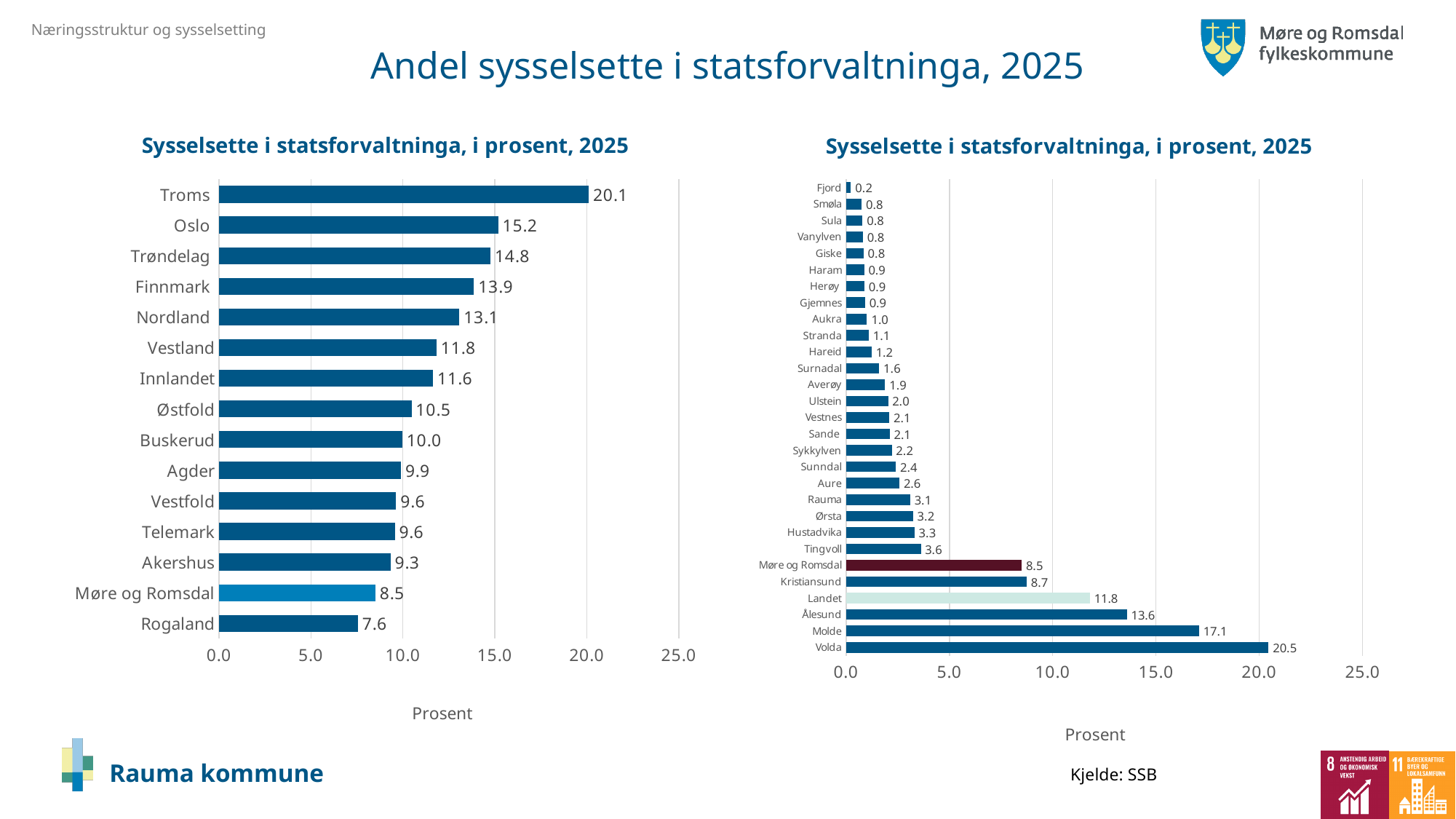
In the right chart, what is the value for Rauma? 3.1 In the right chart, which category has the highest value? Volda In the left chart, what is the difference between the values for Oslo and Trøndelag? 0.4 In the left chart, how many categories are shown? 15 What kind of chart is the right chart? Bar chart In the right chart, which category has the lowest value? Fjord In the right chart, what is the label on the horizontal axis? Prosent In the right chart, is the value for Landet greater or less than 10.0? greater In the left chart, which category has the lowest value? Rogaland In the left chart, which is larger, the value for Nordland or the value for Vestland? Nordland In the right chart, what is the difference between the values for Molde and Ålesund? 3.5 In the left chart, what is the value for Troms? 20.1